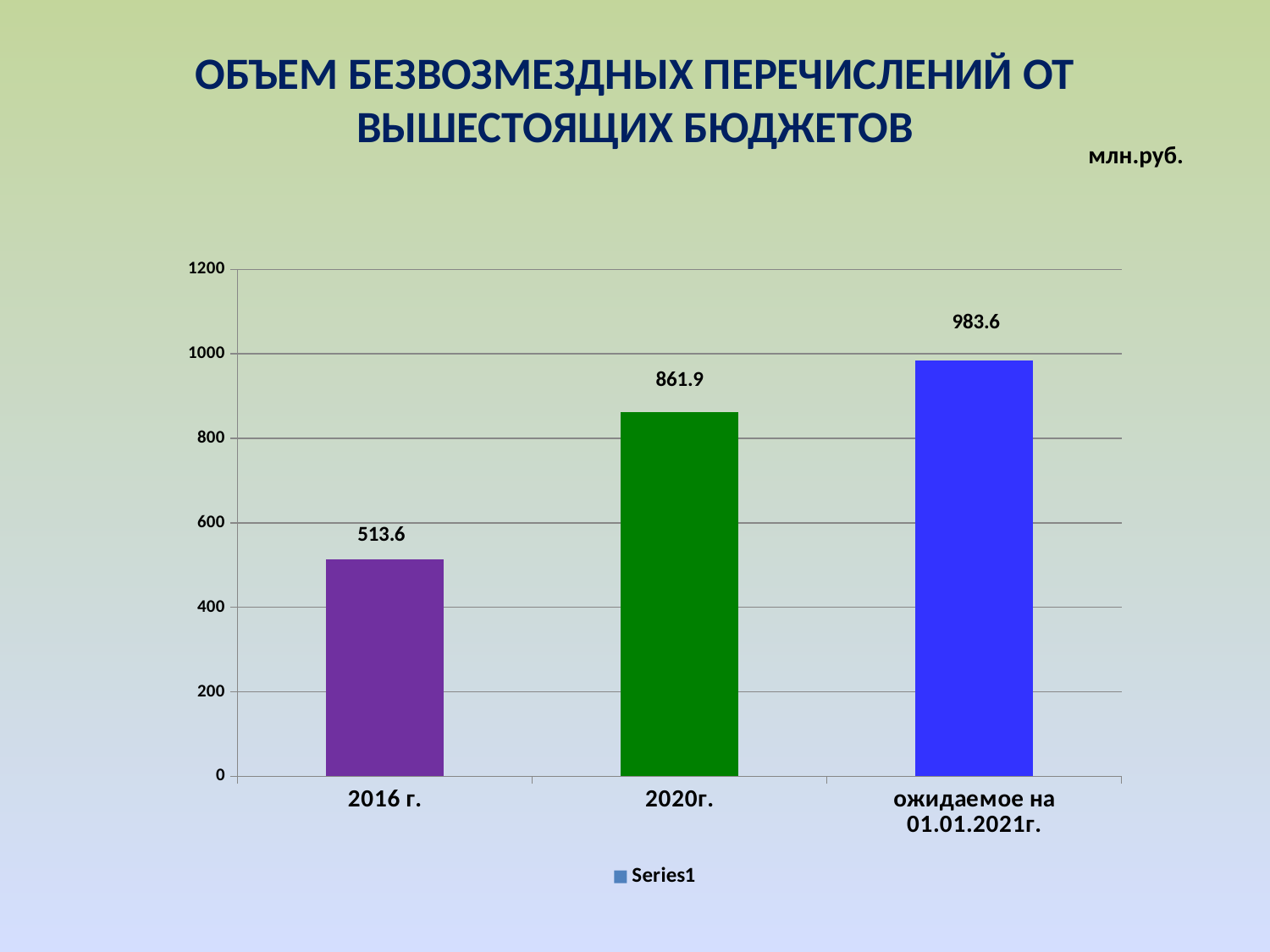
What is the difference between the values for ожидаемое на 01.01.2021г. and 2020г.? 121.7 What is the difference between the values for 2020г. and 2016 г.? 348.3 Which category has the highest value? ожидаемое на 01.01.2021г. Which is larger, the value for 2020г. or the value for 2016 г.? 2020г. Which category has the lowest value? 2016 г. What kind of chart is shown on the slide? bar chart Do the values rise or fall from left to right along the x axis? rise What is the value for 2020г.? 861.9 What is the value for ожидаемое на 01.01.2021г.? 983.6 Is the value for 2020г. greater or less than 800? greater How many categories are shown on the x axis? 3 What is the value for 2016 г.? 513.6